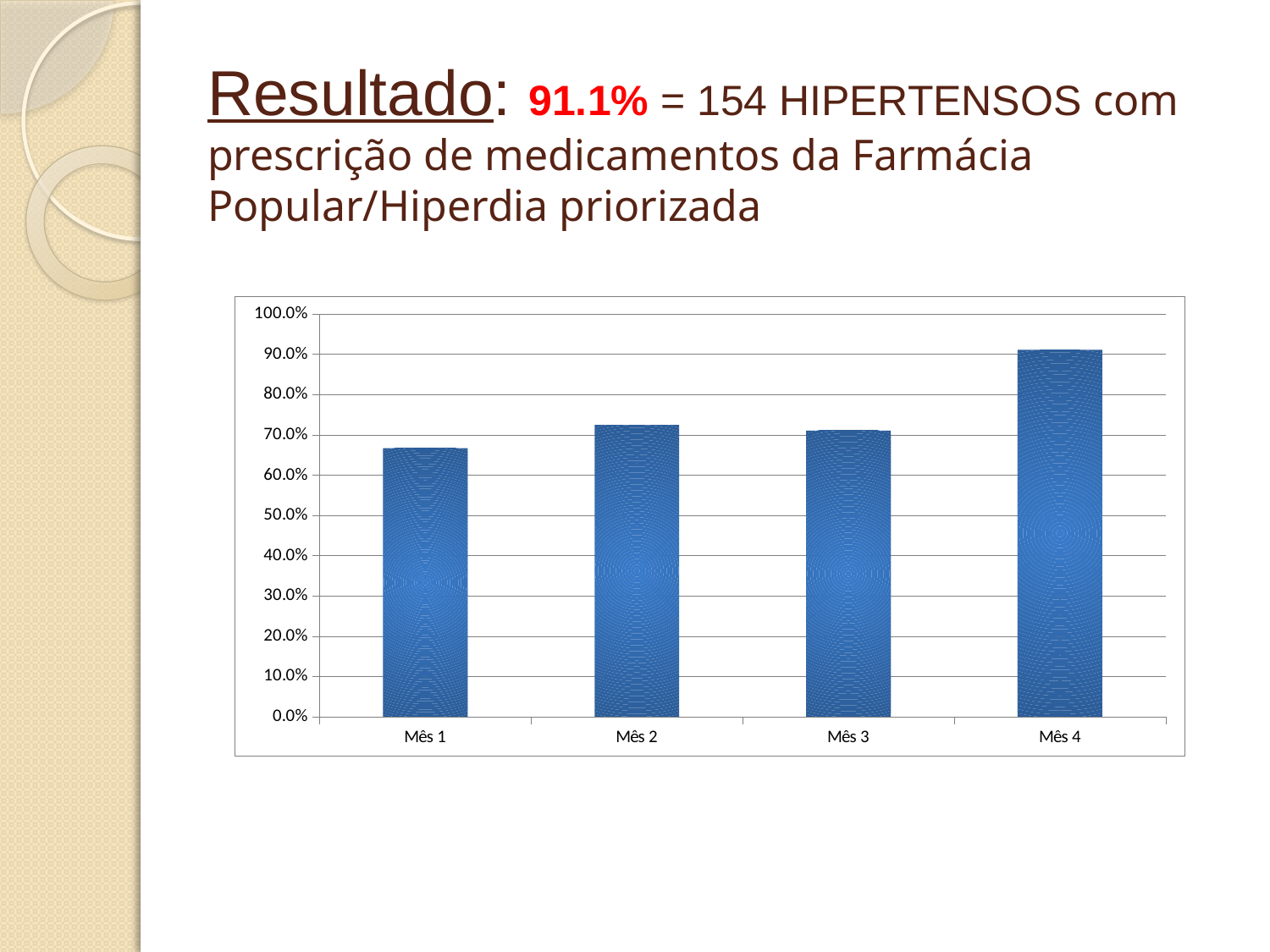
What colour are the bars in the chart? blue Is the value for Mês 4 greater or less than 80.0%? greater What is the maximum value shown on the y axis of the chart? 100.0% Is the value for Mês 2 greater or less than 70.0%? greater Is the value for Mês 1 greater or less than 70.0%? less How many categories (months) are shown on the x axis of the chart? 4 Which month has the lowest value in the chart? Mês 1 Which month has the highest value in the chart? Mês 4 What kind of chart is shown on the slide? bar chart Which is larger, the value for Mês 2 or the value for Mês 1? Mês 2 Which is larger, the value for Mês 4 or the value for Mês 1? Mês 4